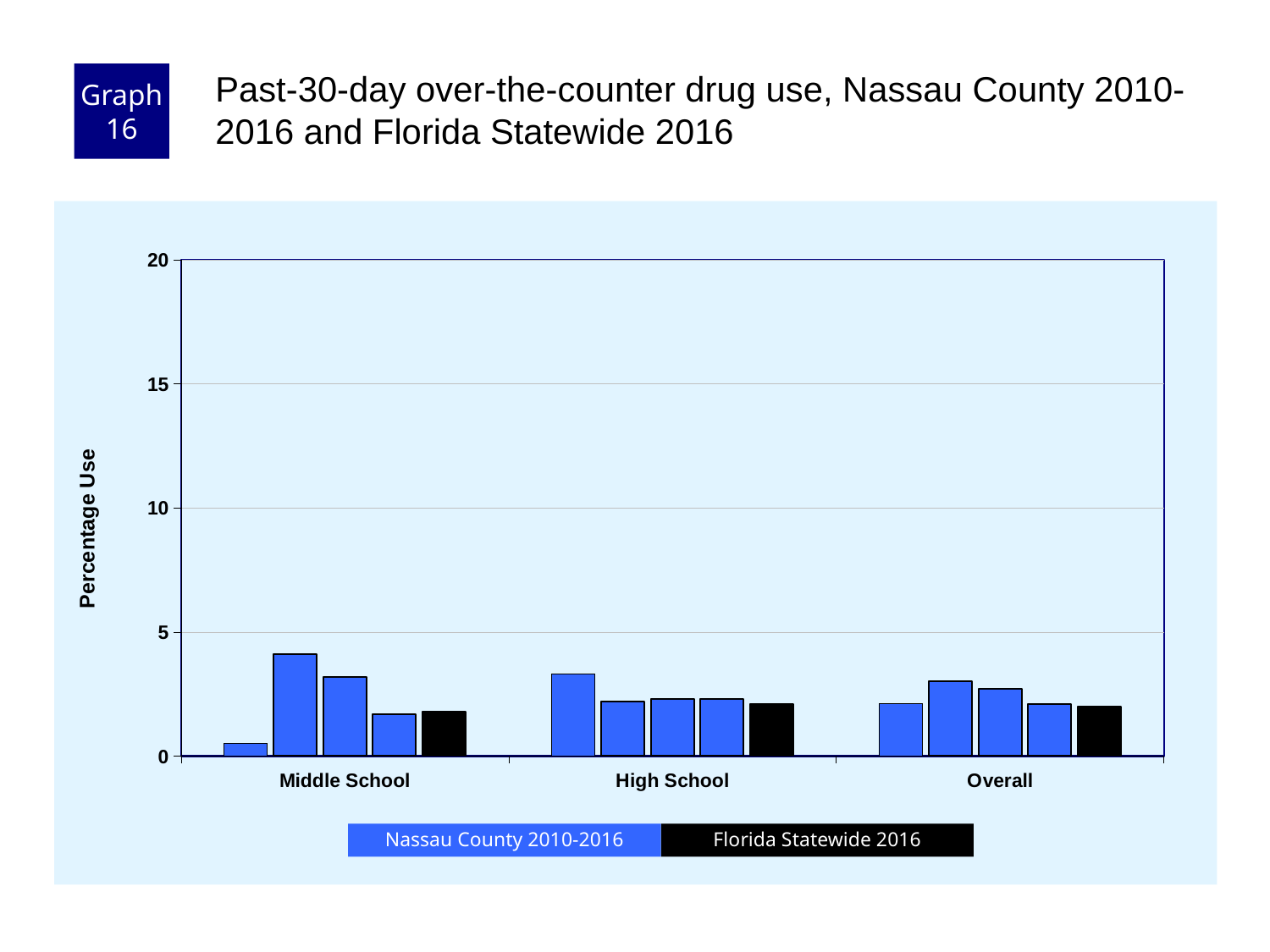
How many series does the legend list? 2 Which category group contains the tallest bar on the chart? Middle School In the Middle School group, does the tallest bar belong to Nassau County 2010-2016 or Florida Statewide 2016? Nassau County 2010-2016 What kind of chart is shown on the slide? bar chart What colour represents Florida Statewide 2016 in the legend? black Is the tallest bar in the Middle School group greater or less than 5? less How many categories are shown along the x axis? 3 Is the Florida Statewide 2016 value for Middle School greater or less than 5? less What is the label on the y axis? Percentage Use Which category group contains the shortest bar on the chart? Middle School Is the Florida Statewide 2016 value for High School greater or less than 5? less